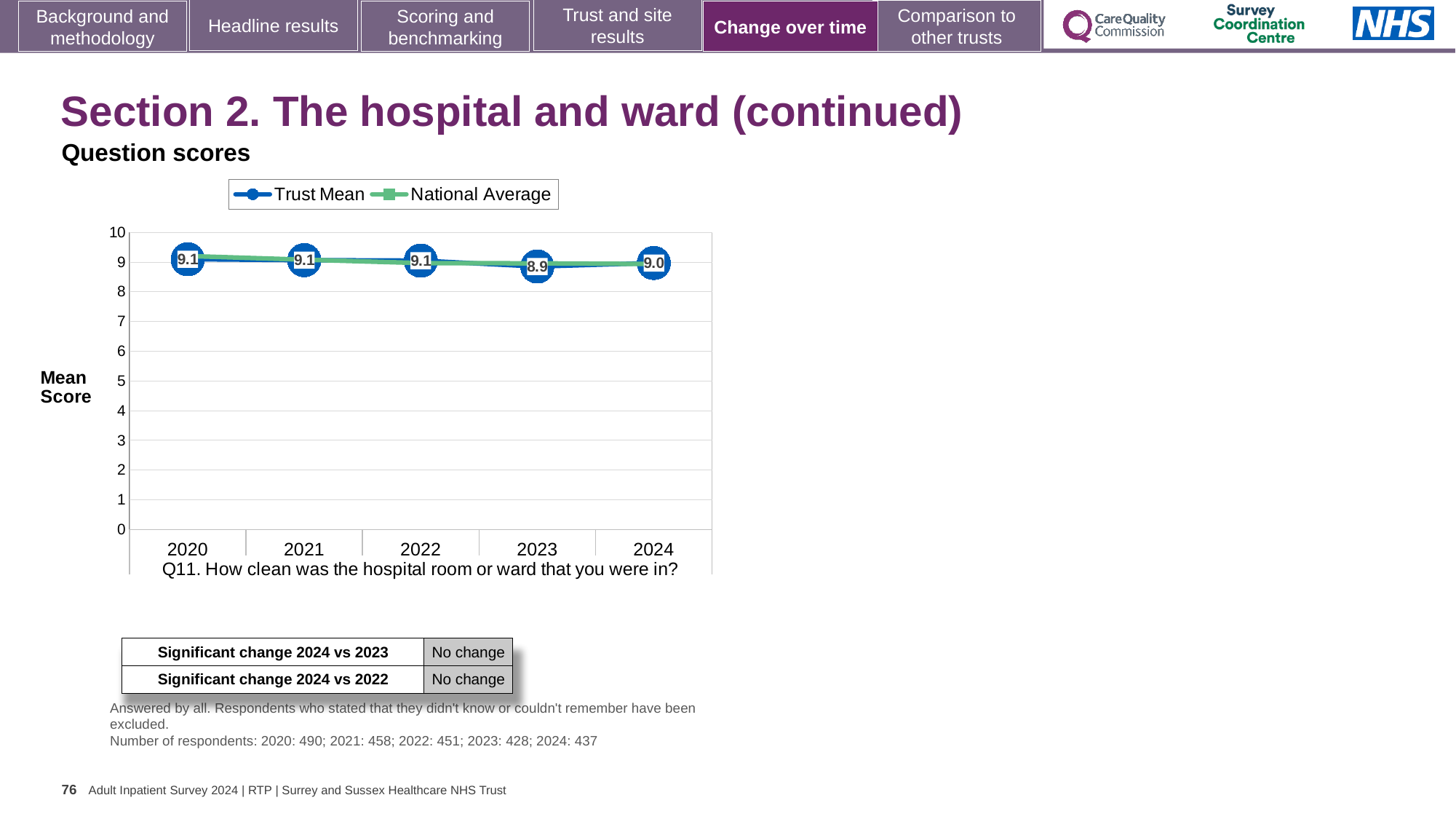
What is the difference between the Trust Mean in 2022 and in 2023? 0.2 Is the National Average for 2024 greater or less than 8? greater What is the Trust Mean for 2023? 8.9 How many series does the legend list? 2 Does the Trust Mean rise or fall from 2022 to 2023? fall What is the Trust Mean for 2020? 9.1 What kind of chart is shown? line chart Which question does the chart relate to? Q11. How clean was the hospital room or ward that you were in? Which is larger, the Trust Mean in 2021 or in 2023? 2021 In which year is the Trust Mean lowest? 2023 What is the Trust Mean for 2024? 9.0 How many years are shown on the x axis? 5